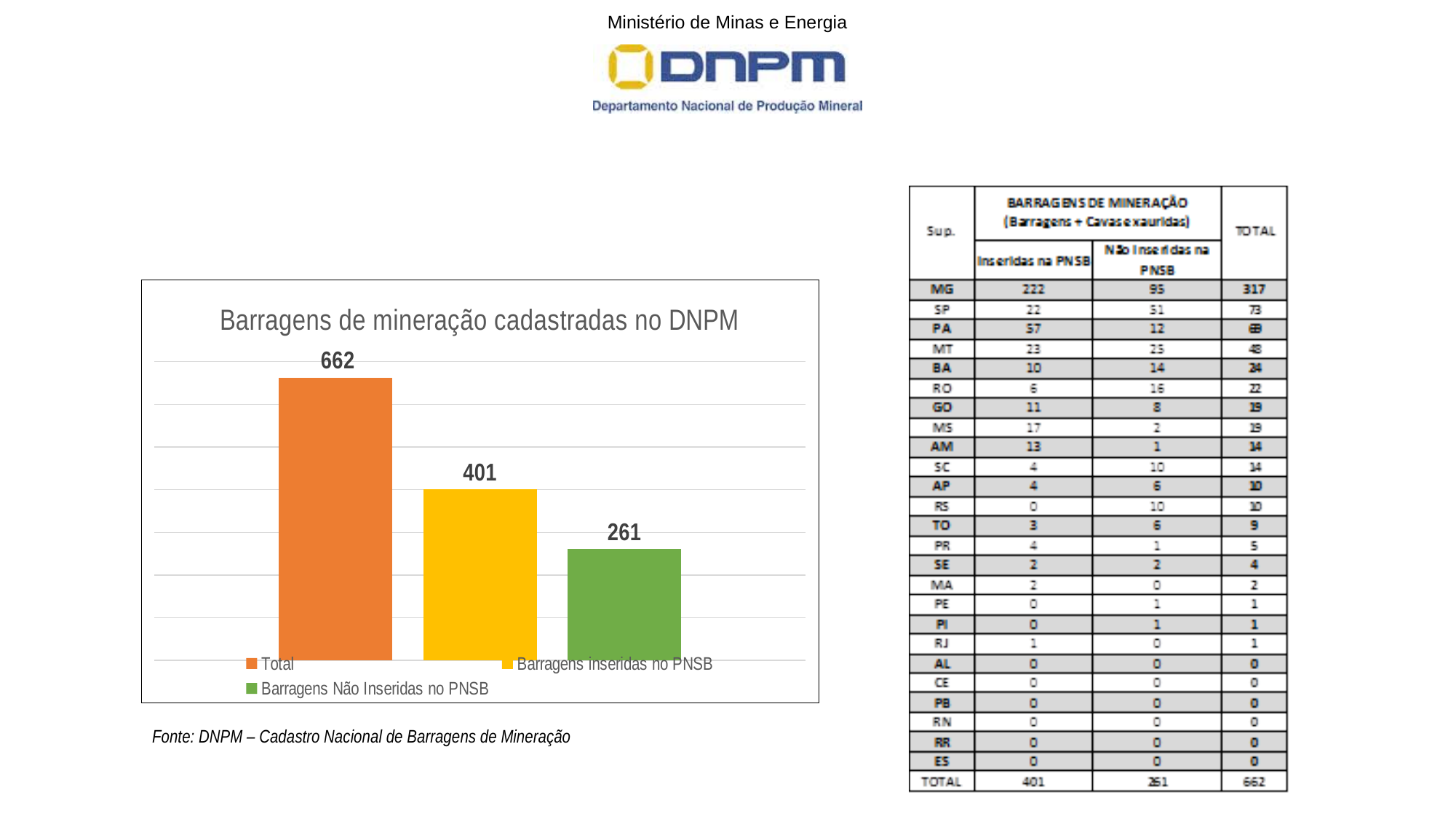
Which series has the lowest value in the chart? Barragens Não Inseridas no PNSB What is the value for Barragens Inseridas no PNSB? 401 What kind of chart is shown on the slide? Bar chart Which series has the highest value in the chart? Total What is the title of the chart? Barragens de mineração cadastradas no DNPM How many series does the chart legend list? 3 How many bars are plotted in the chart? 3 Which is larger, Barragens Inseridas no PNSB or Barragens Não Inseridas no PNSB? Barragens Inseridas no PNSB What is the value for Barragens Não Inseridas no PNSB? 261 What is the value of the Total bar in the chart? 662 What is the difference between Barragens Inseridas no PNSB and Barragens Não Inseridas no PNSB? 140 What is the difference between the Total bar and the Barragens Inseridas no PNSB bar? 261